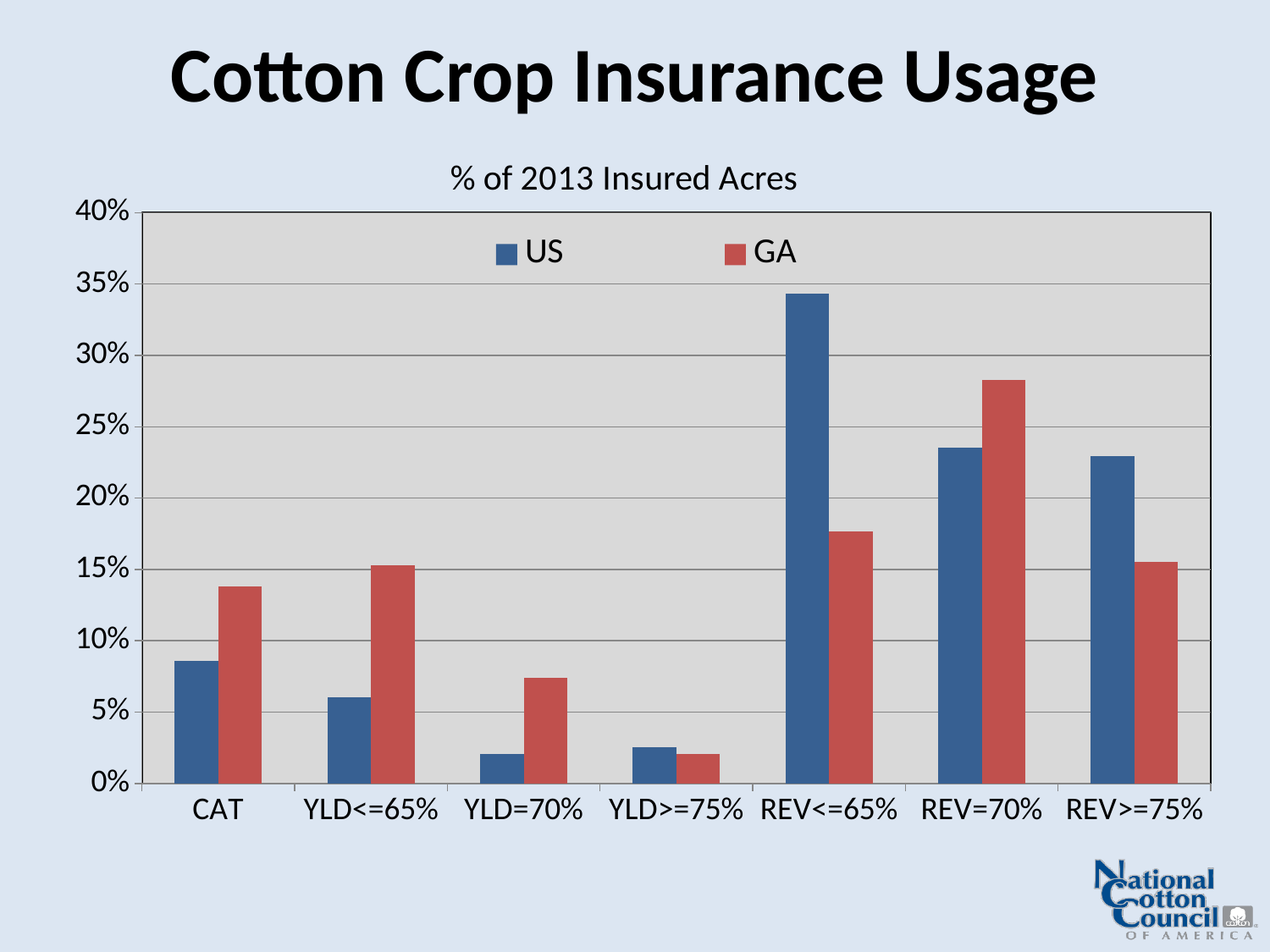
For REV=70%, which series has the larger value, US or GA? GA How many categories are shown on the x axis? 7 Is the US value for YLD=70% greater or less than 5%? less Is the US value for CAT greater or less than 10%? less Is the GA value for REV=70% greater or less than 25%? greater For which category is the GA value highest? REV=70% What kind of chart is shown on the slide? bar chart For which category is the GA value lowest? YLD>=75% For which category is the US value highest? REV<=65% How many series does the legend list? 2 What is the subtitle shown above the chart? % of 2013 Insured Acres